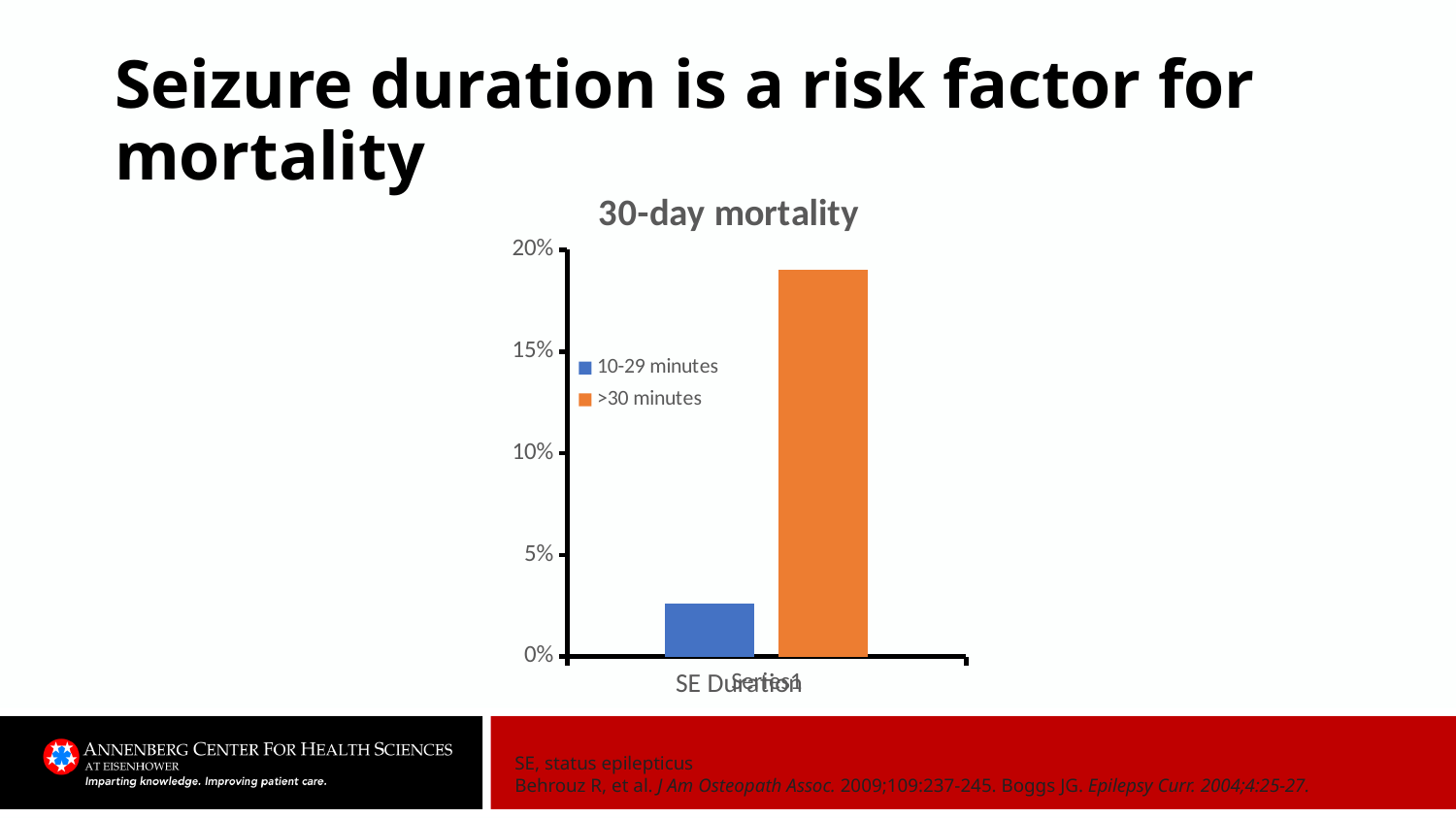
Which series has the highest 30-day mortality? >30 minutes Which is larger, the 30-day mortality for 10-29 minutes or for >30 minutes? >30 minutes Is the 30-day mortality for >30 minutes greater or less than 20%? less How many series does the legend list? 2 What colour is the bar for the >30 minutes series? orange Which series has the lowest 30-day mortality? 10-29 minutes What is the title of the chart? 30-day mortality How many bars are plotted in the chart? 2 Is the 30-day mortality for 10-29 minutes greater or less than 5%? less Is the 30-day mortality for >30 minutes greater or less than 15%? greater What is the highest value shown on the vertical axis? 20% What kind of chart is shown on the slide? bar chart